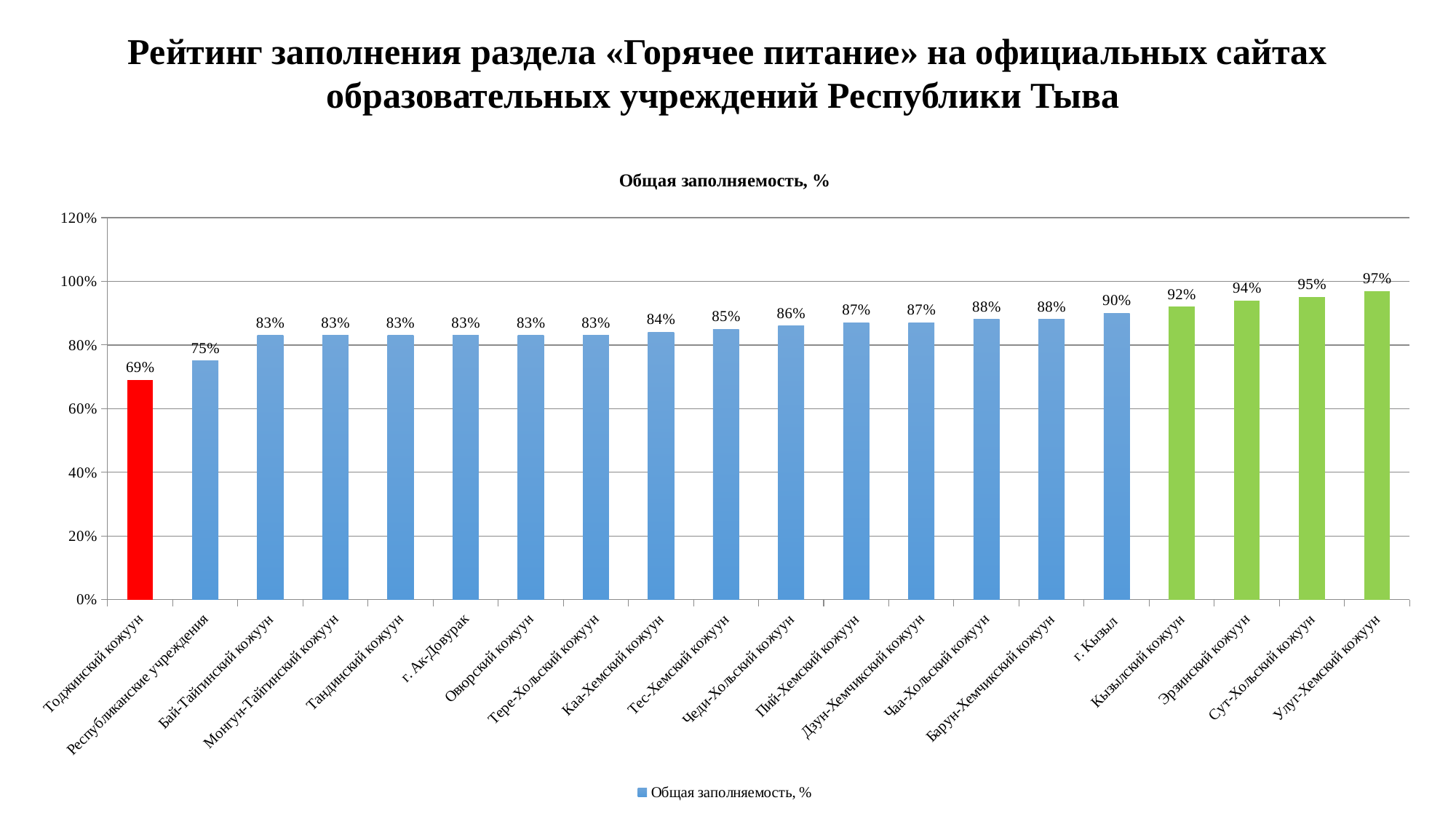
What is the chart's title? Общая заполняемость, % Which is larger, the value for Эрзинский кожуун or the value for Кызылский кожуун? Эрзинский кожуун How many series does the legend list? 1 Is the value for Сут-Хольский кожуун greater or less than 80%? greater What is the difference between the values for Улуг-Хемский кожуун and Тоджинский кожуун? 28% What is the value for г. Кызыл? 90% Which category has the lowest value? Тоджинский кожуун What is the value for Тоджинский кожуун? 69% How many categories are shown on the x axis? 20 Which category has the highest value? Улуг-Хемский кожуун What is the value for Республиканские учреждения? 75% What kind of chart is shown? bar chart